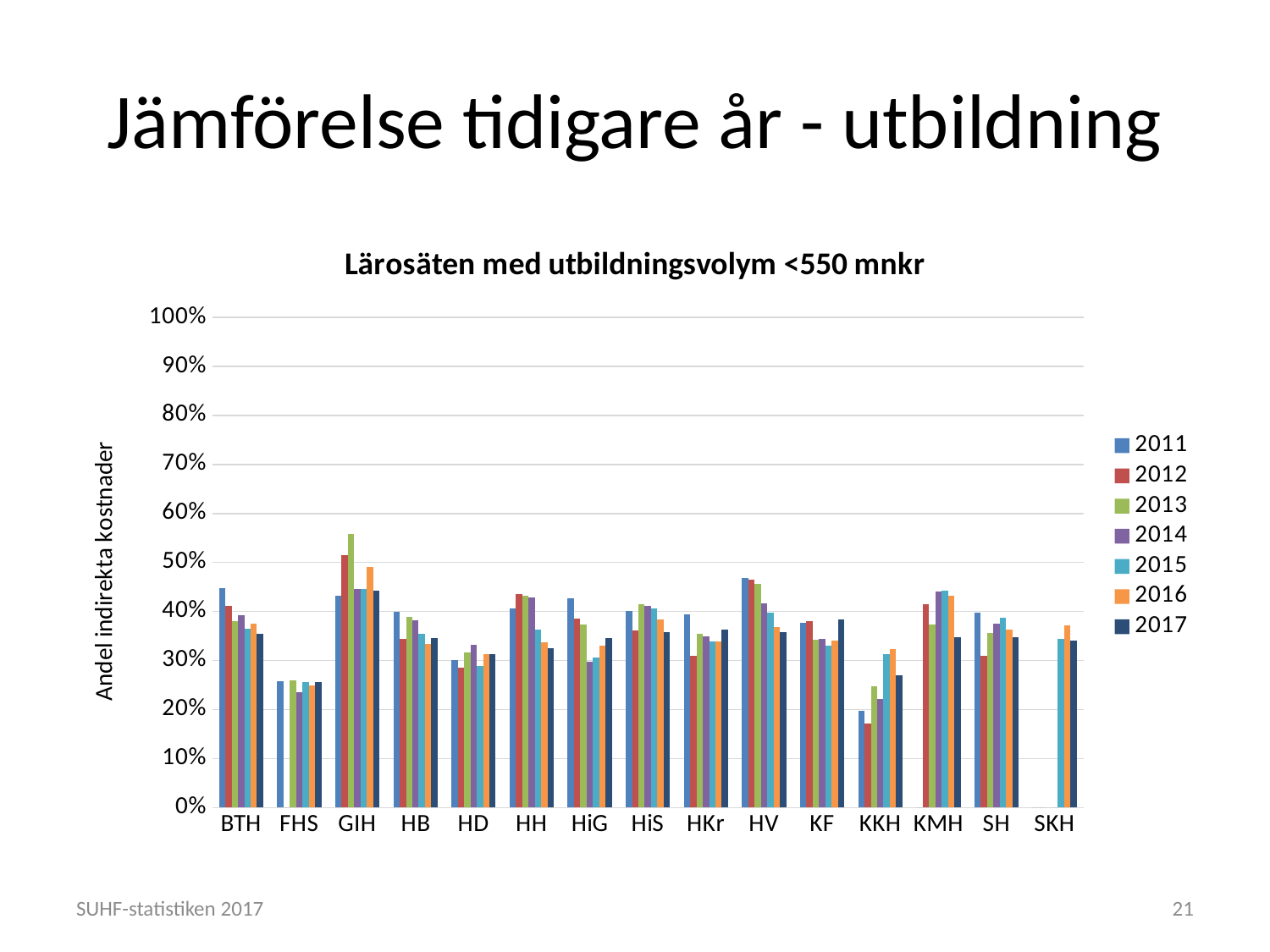
What is the title of the chart? Lärosäten med utbildningsvolym <550 mnkr Which is larger, the 2011 value for BTH or the 2011 value for HB? BTH Is the 2012 value for KKH greater or less than 20%? less Which institution and year has the lowest bar in the chart? KKH, 2012 Which institution and year has the highest bar in the chart? GIH, 2013 What kind of chart is shown on the slide? bar chart How many institutions (categories) are shown on the x axis? 15 Is the 2011 value for HV greater or less than 40%? greater Is the 2013 value for GIH greater or less than 50%? greater How many series does the legend list? 7 What is the label on the vertical axis? Andel indirekta kostnader